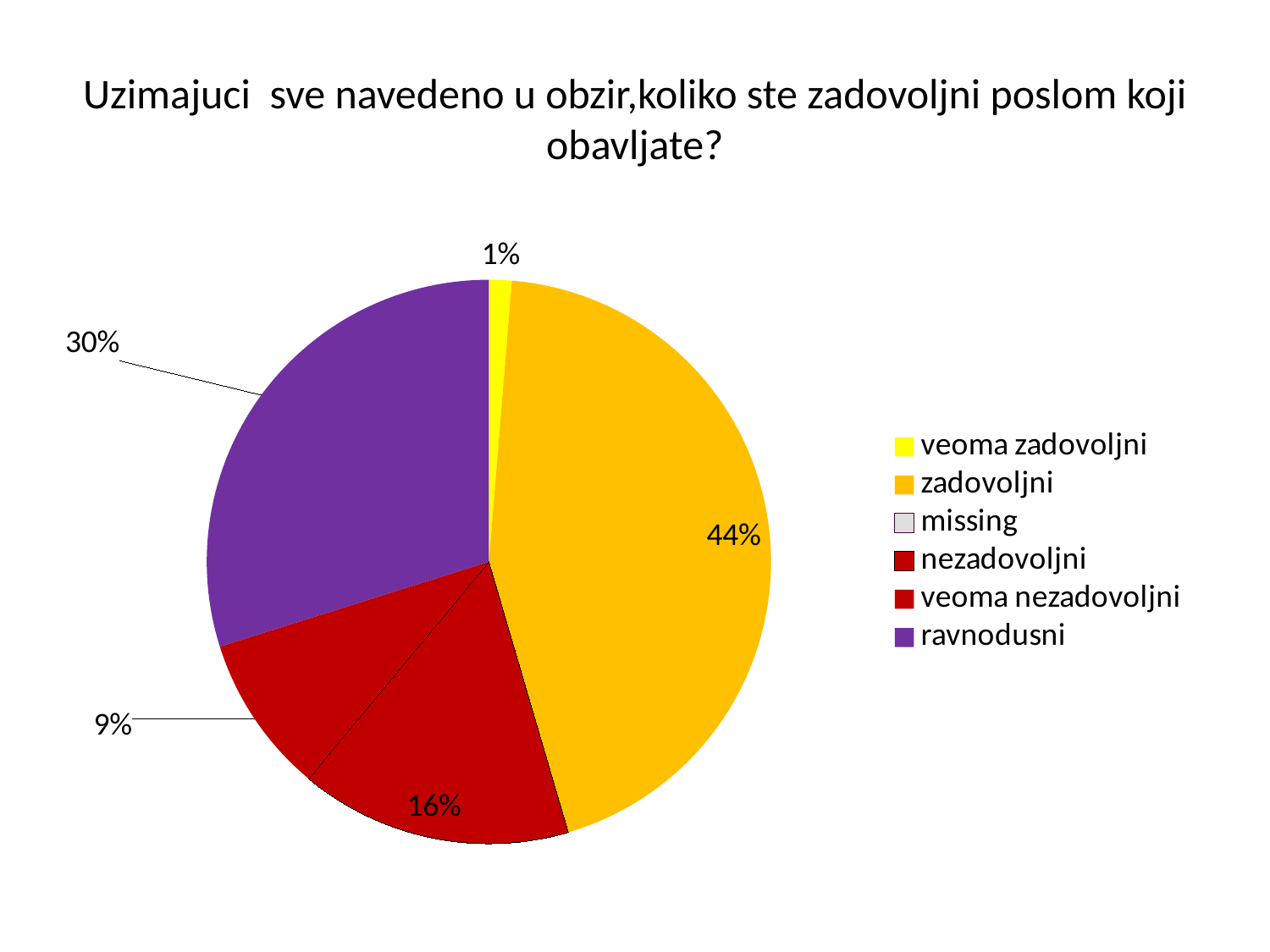
Which slice is larger, 'ravnodusni' or 'veoma zadovoljni'? ravnodusni Which category has the largest slice of the pie? zadovoljni What colour is the 'ravnodusni' slice? purple What is the difference in percentage points between the 16% slice and the 9% slice? 7 What share of the pie does the 'veoma zadovoljni' slice represent? 1% How many entries does the legend list? 6 What colour is the 'zadovoljni' slice? orange What kind of chart is shown on the slide? pie chart Which labelled slice of the pie is the smallest? veoma zadovoljni What share of the pie does the 'ravnodusni' slice represent? 30% What is the difference in percentage points between the 'zadovoljni' slice and the 'ravnodusni' slice? 14 What share of the pie does the 'zadovoljni' slice represent? 44%